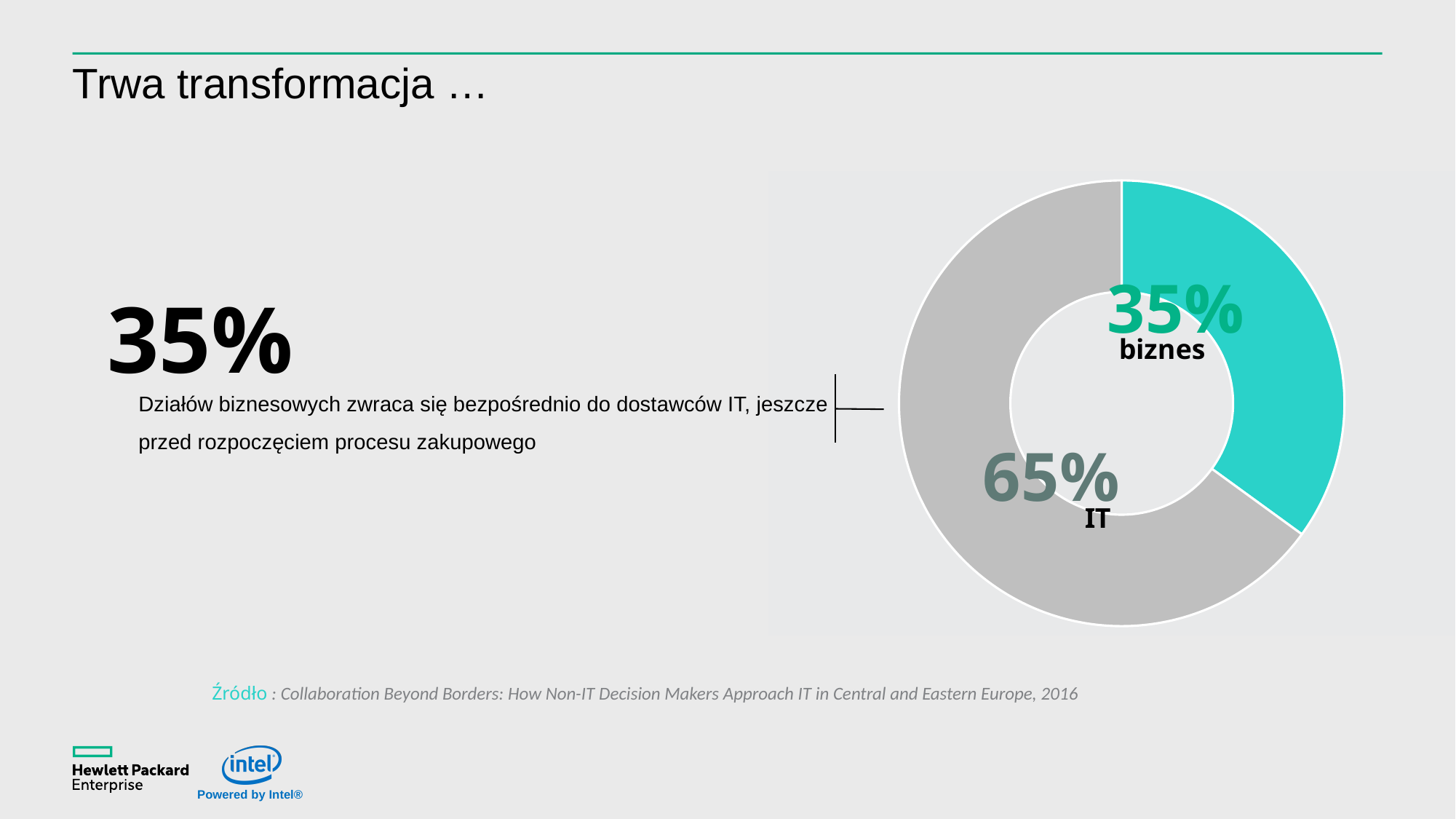
What colour is the 'biznes' slice? Teal Which slice is the largest? IT How many slices does the chart have? 2 Which is larger, the 'biznes' slice or the 'IT' slice? IT What is the difference between the 'IT' and 'biznes' slices? 30% What is the value for the 'IT' slice? 65% What is the value for the 'biznes' slice? 35% Which slice is the smallest? biznes What colour is the 'IT' slice? Grey What share of the chart does the 'biznes' slice represent? 35% What kind of chart is shown on the slide? Doughnut chart